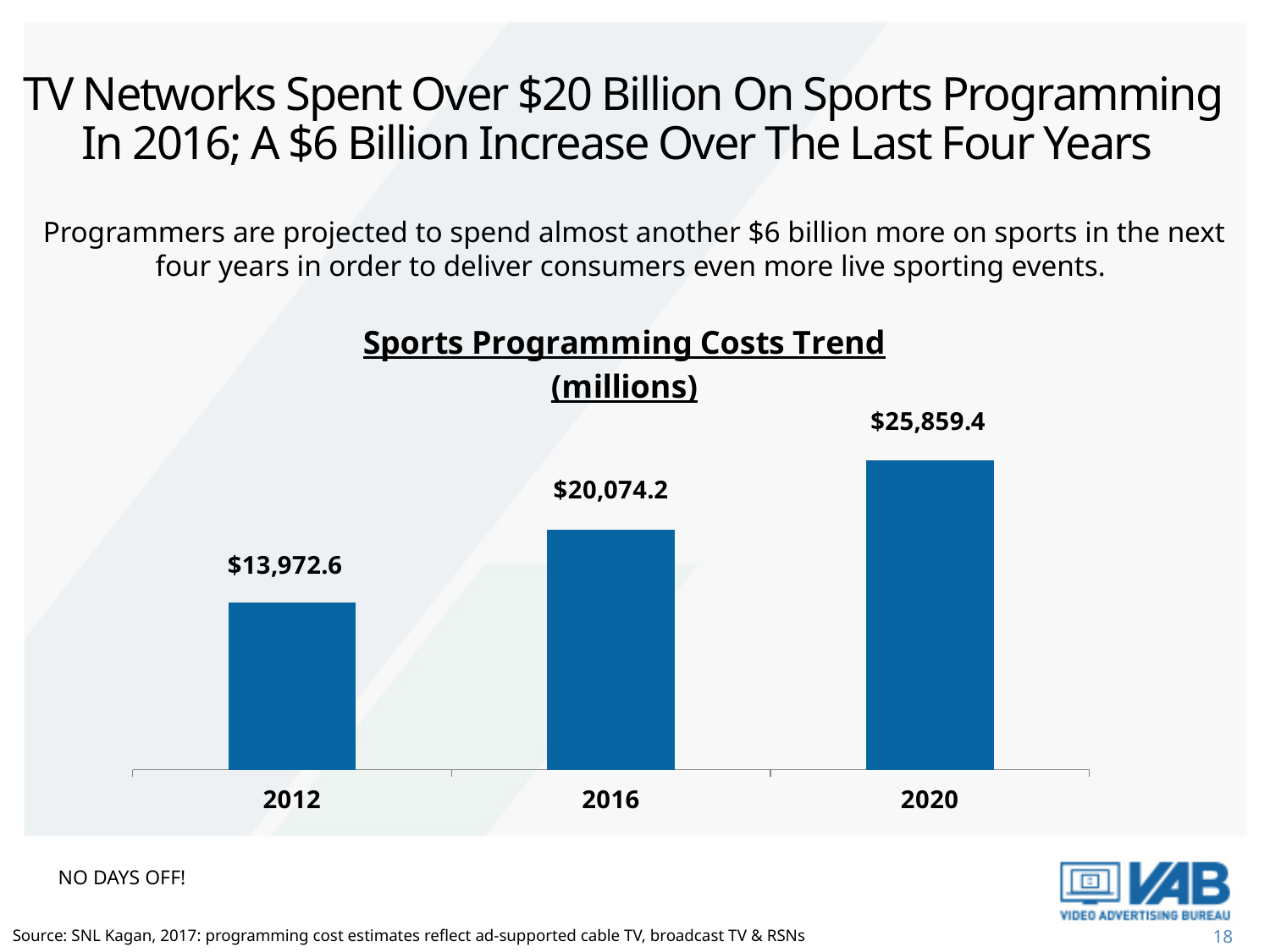
Which year has the lowest sports programming cost? 2012 What is the value for 2016? $20,074.2 What is the title of the chart? Sports Programming Costs Trend (millions) Which year has the highest sports programming cost? 2020 Do the values rise or fall from 2012 to 2020? rise What is the value for 2012? $13,972.6 How many years are shown on the chart? 3 What kind of chart is shown? bar chart What is the difference between the 2016 and 2012 values? $6,101.6 What is the difference between the 2020 and 2016 values? $5,785.2 What is the value for 2020? $25,859.4 Which is larger, the value for 2016 or the value for 2020? 2020